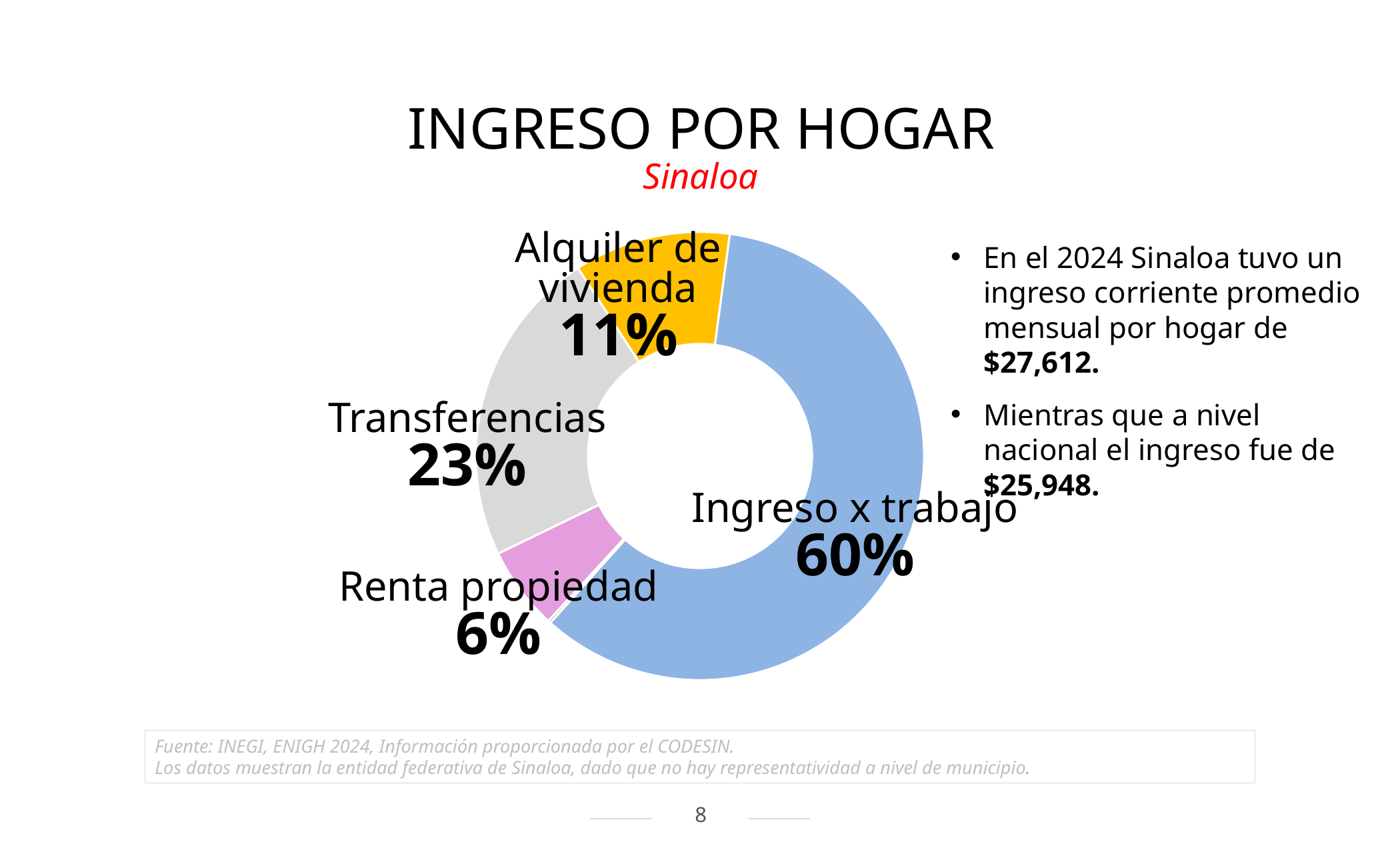
What percentage is shown for Transferencias? 23% What percentage is shown for Alquiler de vivienda? 11% What share of household income does Ingreso x trabajo represent? 60% What is the title of the slide containing the chart? INGRESO POR HOGAR What kind of chart is shown on the slide? Doughnut (pie) chart How many categories are shown in the chart? 4 What is the difference in percentage points between Alquiler de vivienda and Renta propiedad? 5 What is the difference in percentage points between Ingreso x trabajo and Transferencias? 37 Which is larger, Transferencias or Alquiler de vivienda? Transferencias Which category has the largest share of the chart? Ingreso x trabajo What percentage is shown for Renta propiedad? 6% Which category has the smallest share of the chart? Renta propiedad